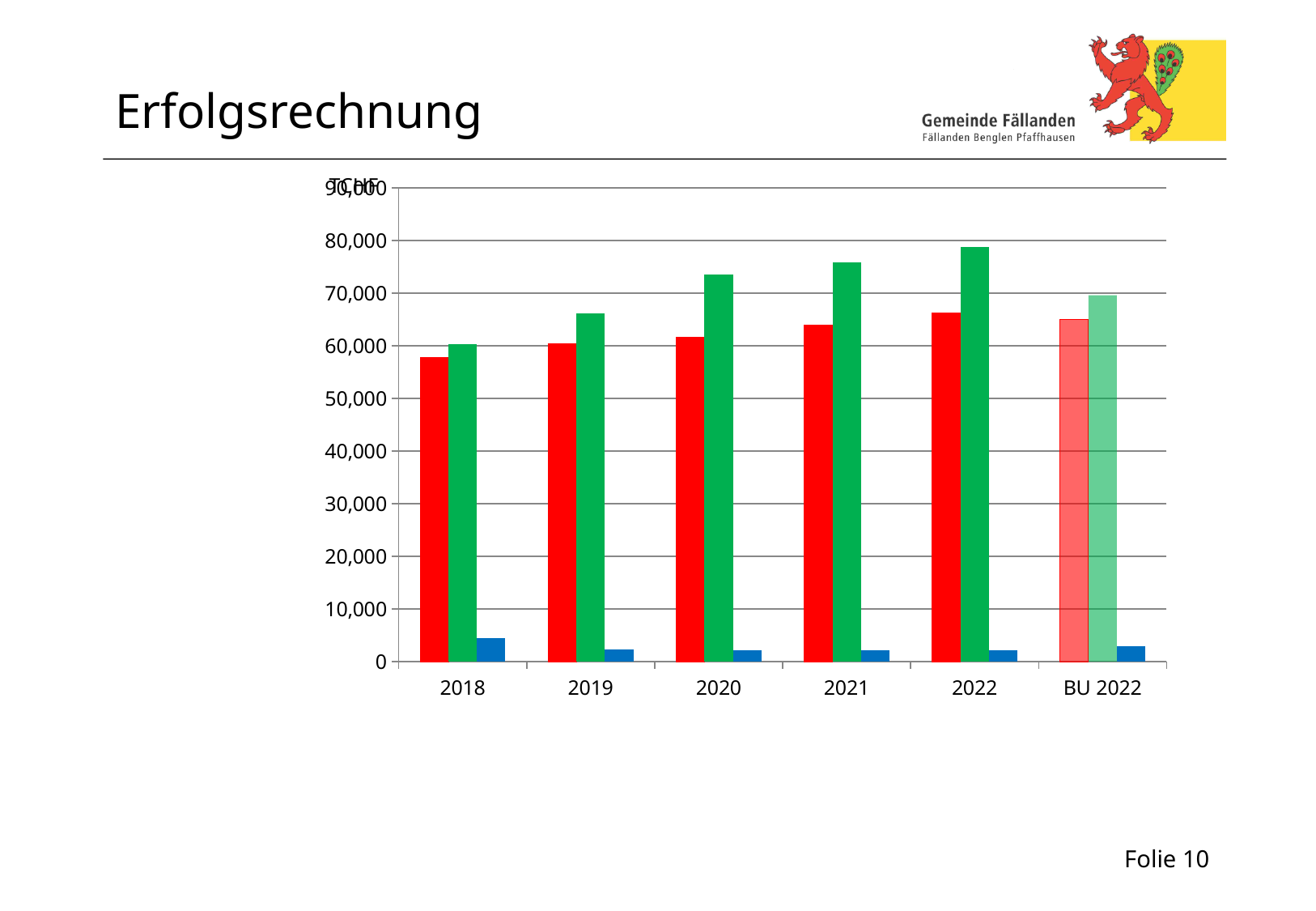
How many categories are shown on the x axis of the chart? 6 Is the value of the green bar for 2022 greater or less than 70,000? greater In 2022, which is larger: the red bar or the green bar? the green bar Do the green bars rise or fall from 2018 to 2022? rise Is the value of the blue bar for 2018 greater or less than 10,000? less In which category does the green bar reach its highest value? 2022 What is the title of the slide containing the chart? Erfolgsrechnung Is the value of the green bar for 2020 greater or less than 70,000? greater How many bars are plotted for each category on the x axis? 3 What kind of chart is shown on the slide? bar chart Which is larger: the blue bar for 2018 or the blue bar for 2019? the blue bar for 2018